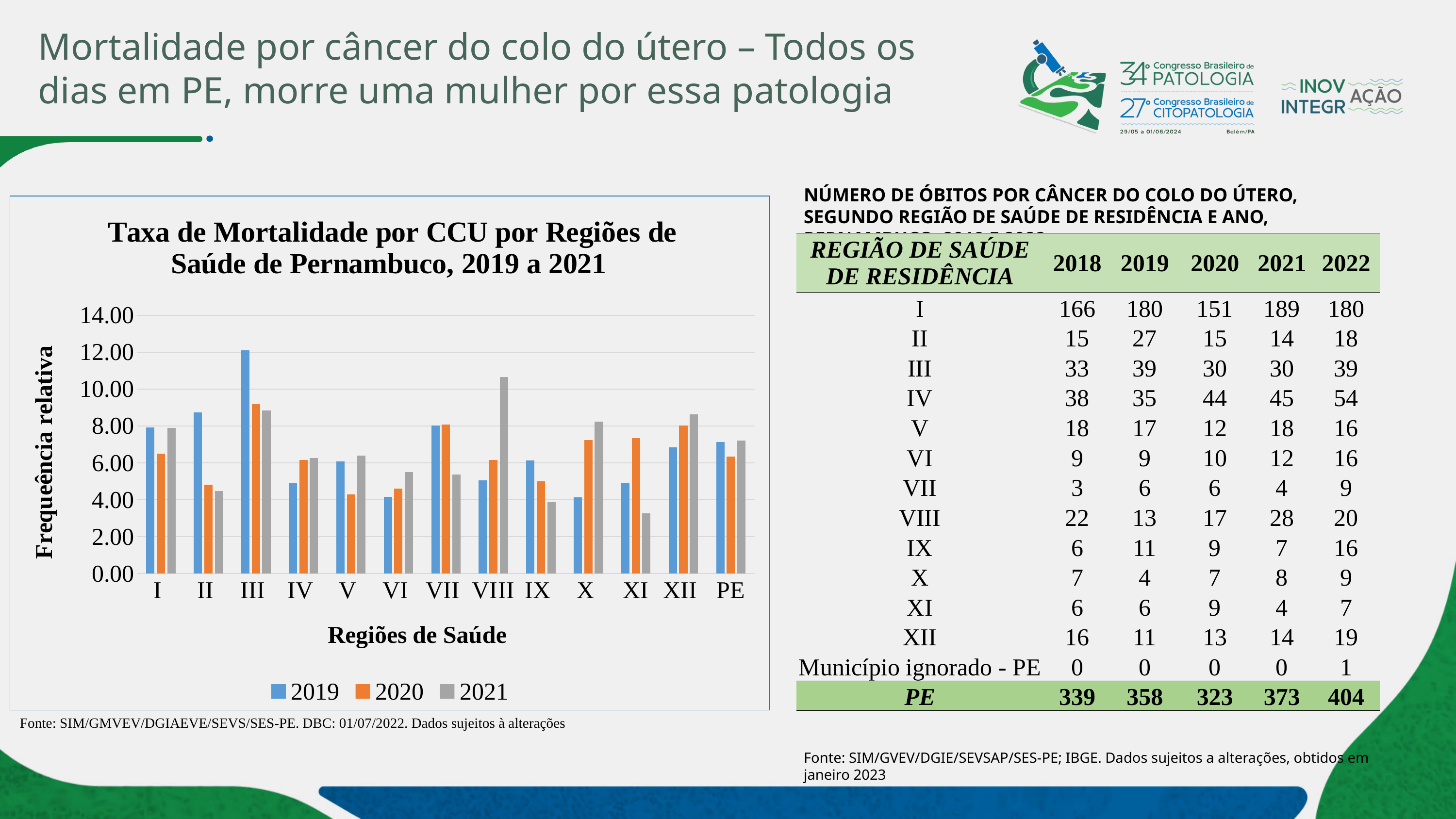
Is the 2019 value for region II greater or less than 8.00? greater Is the 2019 value for region III greater or less than 10.00? greater Which region has the highest 2021 value in the chart? VIII Which region has the highest 2019 value in the chart? III How many series does the chart legend list? 3 For region VIII, which is larger: the 2019 value or the 2021 value? 2021 For region XI, which is larger: the 2020 value or the 2021 value? 2020 How many categories are shown on the x axis of the chart? 13 What is the title of the chart's vertical axis? Frequência relativa Which region has the lowest 2021 value in the chart? XI What kind of chart is shown on the slide? bar chart Is the 2021 value for region XI greater or less than 4.00? less